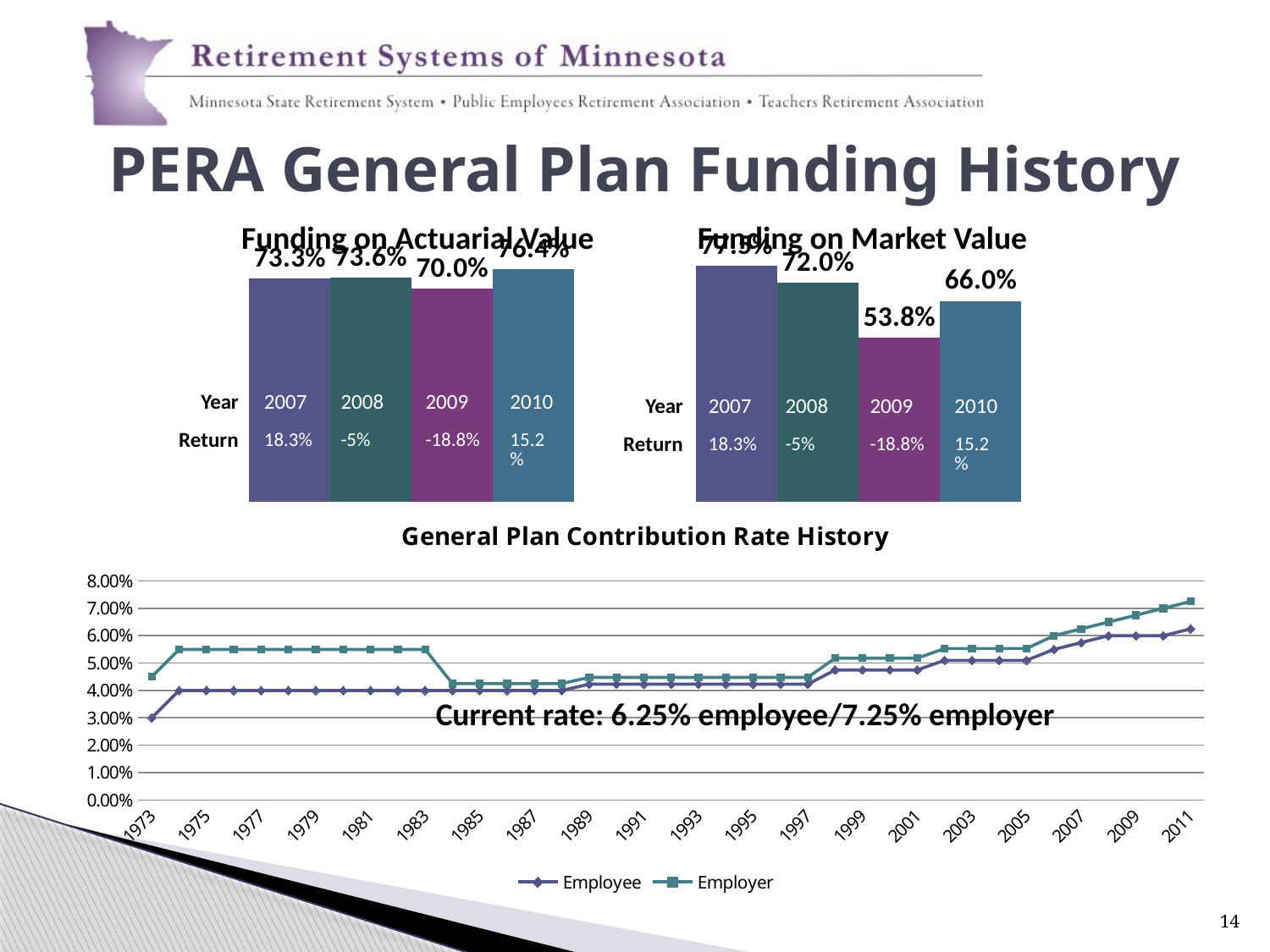
In the Funding on Market Value chart, which year has the lowest funding value? 2009 In the Funding on Actuarial Value chart, which year has the lowest funding value? 2009 How many years are shown in the Funding on Actuarial Value chart? 4 What kind of chart is the General Plan Contribution Rate History chart? line chart In the General Plan Contribution Rate History chart, is the Employer value for 2011 greater or less than 7.00%? greater In the Funding on Market Value chart, what is the difference between the 2008 and 2009 funding values? 18.2% How many series does the legend of the General Plan Contribution Rate History chart list? 2 In the Funding on Market Value chart, what is the funding value for 2009? 53.8% In the Funding on Market Value chart, what return is shown for 2009? -18.8% In the Funding on Actuarial Value chart, what is the funding value for 2008? 73.6% In the Funding on Actuarial Value chart, what is the funding value for 2009? 70.0% In the Funding on Market Value chart, what is the funding value for 2010? 66.0%